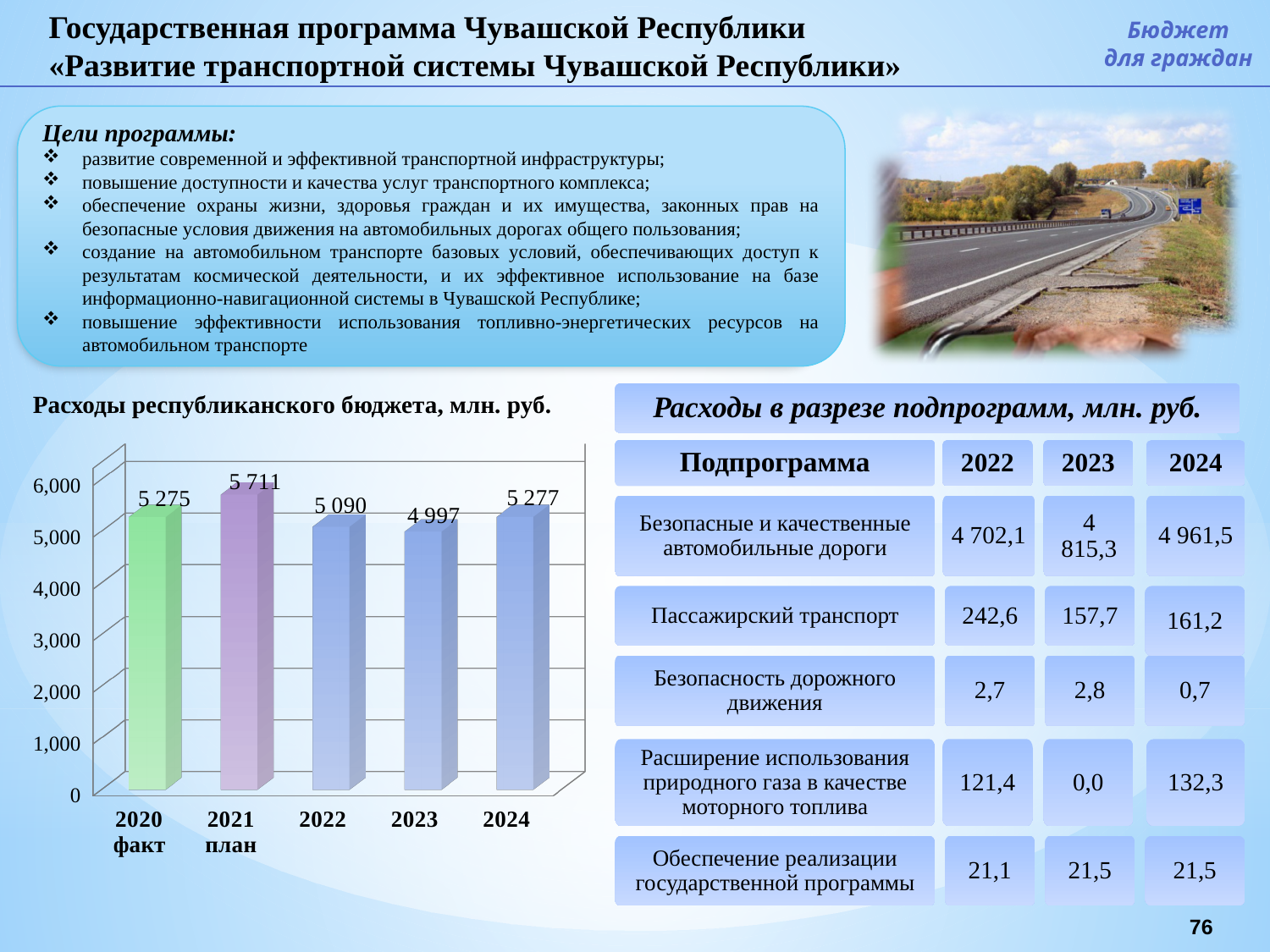
What is the difference between the values for 2024 and 2023 in the chart 'Расходы республиканского бюджета, млн. руб.'? 280 How many bars are shown in the chart 'Расходы республиканского бюджета, млн. руб.'? 5 In the chart 'Расходы республиканского бюджета, млн. руб.', which is larger: the value for 2020 факт or the value for 2022? 2020 факт What type of chart is 'Расходы республиканского бюджета, млн. руб.'? bar chart What is the value for 2023 in the chart 'Расходы республиканского бюджета, млн. руб.'? 4 997 What is the value for 2021 план in the chart 'Расходы республиканского бюджета, млн. руб.'? 5 711 What is the value for 2020 факт in the chart 'Расходы республиканского бюджета, млн. руб.'? 5 275 In the chart 'Расходы республиканского бюджета, млн. руб.', is the value for 2023 greater or less than 5,000? less What is the difference between the values for 2021 план and 2022 in the chart 'Расходы республиканского бюджета, млн. руб.'? 621 Which year has the highest value in the chart 'Расходы республиканского бюджета, млн. руб.'? 2021 план In the chart 'Расходы республиканского бюджета, млн. руб.', do the values rise or fall from 2021 план to 2023? fall Which year has the lowest value in the chart 'Расходы республиканского бюджета, млн. руб.'? 2023